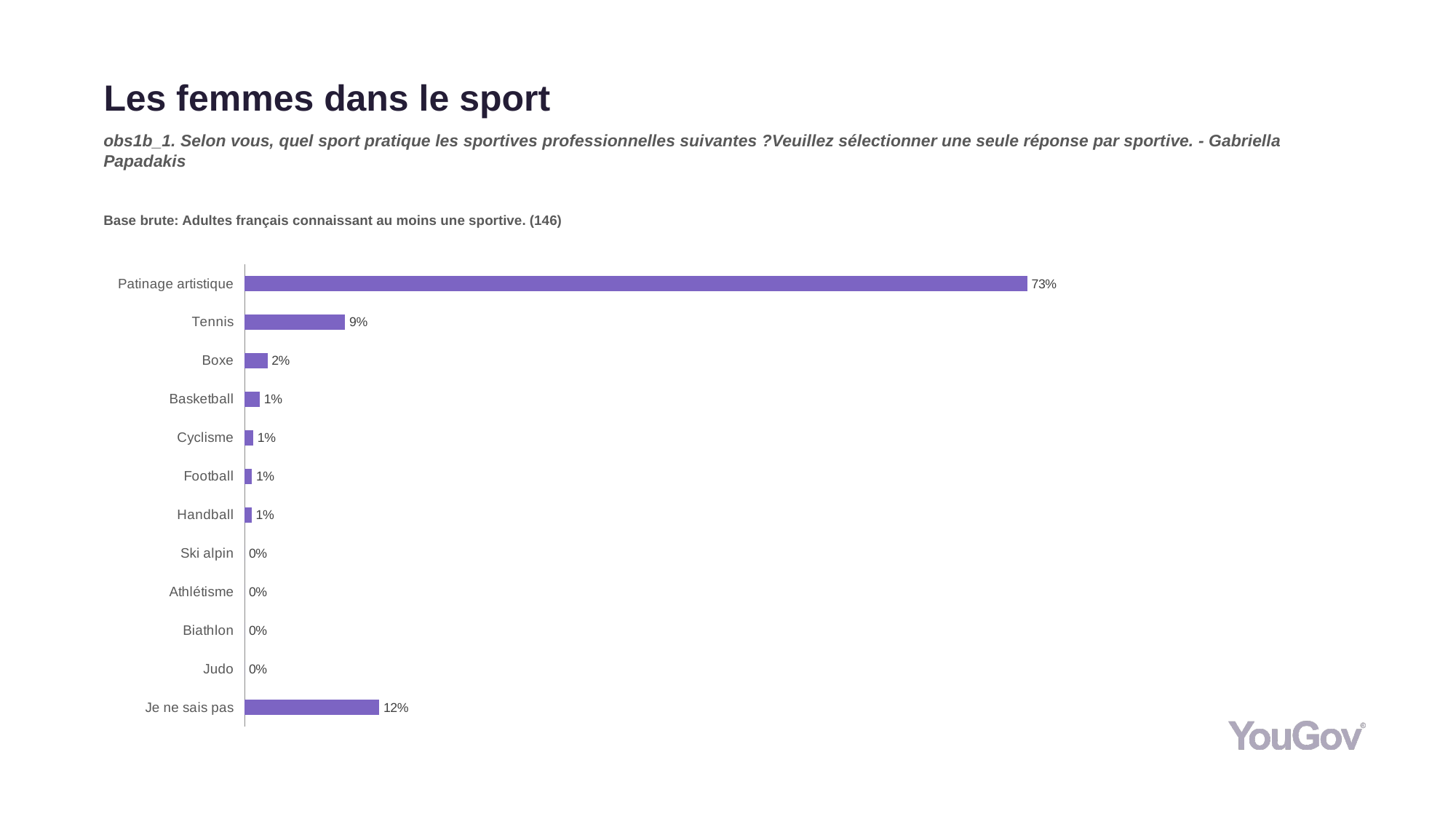
What is the difference between the values for Je ne sais pas and Tennis? 3% How many categories have a value of 0%? 4 What is the value for Je ne sais pas? 12% What is the value for Patinage artistique? 73% What is the value for Judo? 0% Which category has the highest value? Patinage artistique What is the difference between the values for Patinage artistique and Tennis? 64% What is the value for Tennis? 9% What kind of chart is shown on the slide? Bar chart How many categories are shown in the chart? 12 Which is larger, the value for Tennis or the value for Je ne sais pas? Je ne sais pas What is the value for Boxe? 2%